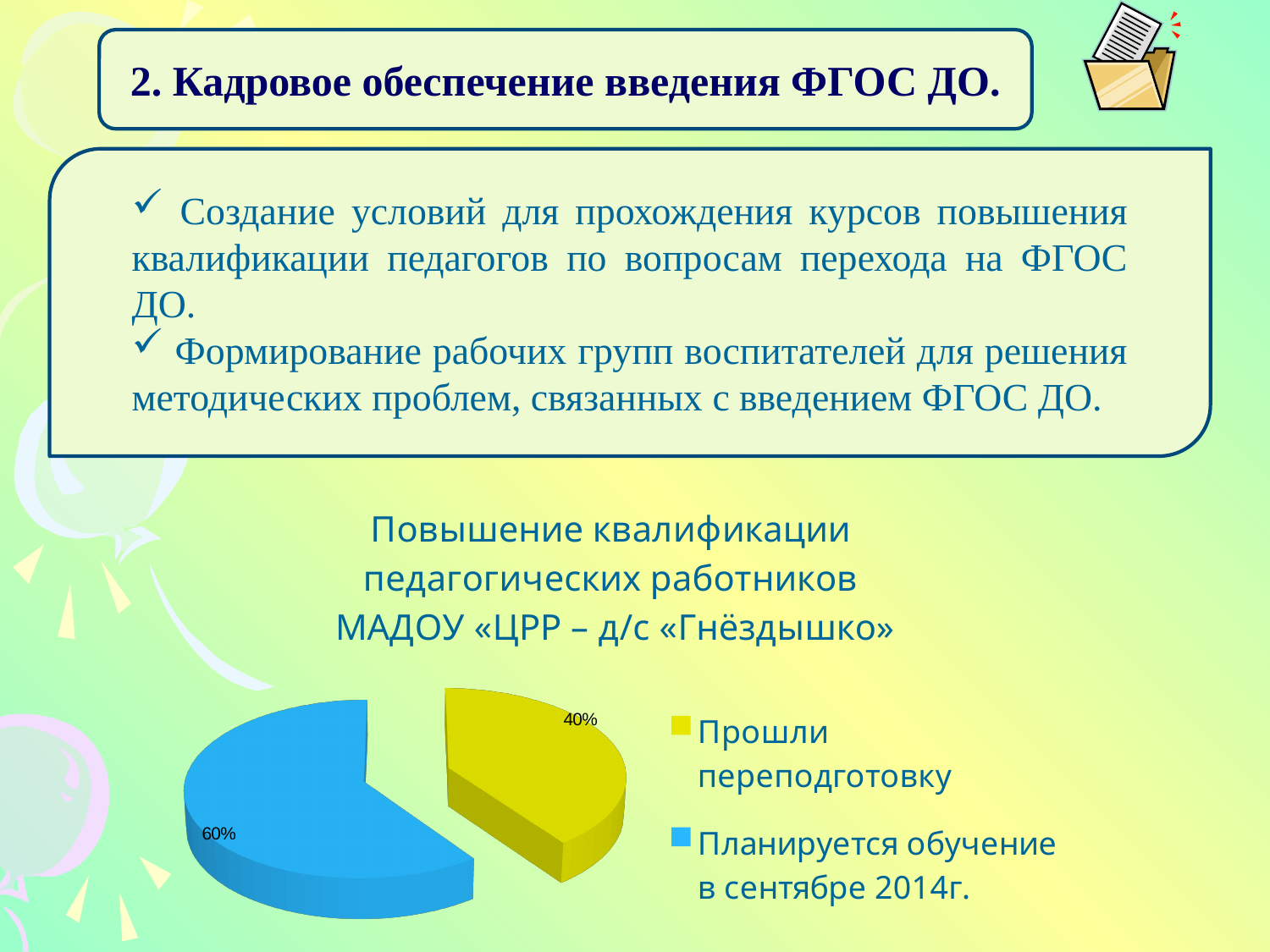
Which is larger: the share for "Прошли переподготовку" or the share for "Планируется обучение в сентябре 2014г."? Планируется обучение в сентябре 2014г. How many slices does the pie chart have? 2 What kind of chart is shown on the slide? Pie chart Which slice of the pie chart is the smallest? Прошли переподготовку Which slice of the pie chart is the largest? Планируется обучение в сентябре 2014г. How many entries does the chart legend list? 2 What share of the pie is labelled "Планируется обучение в сентябре 2014г."? 60% What is the difference in percentage points between the "Планируется обучение в сентябре 2014г." slice and the "Прошли переподготовку" slice? 20% What share of the pie is labelled "Прошли переподготовку"? 40% What colour is the slice for "Прошли переподготовку"? Yellow What is the title of the pie chart? Повышение квалификации педагогических работников МАДОУ «ЦРР – д/с «Гнёздышко»